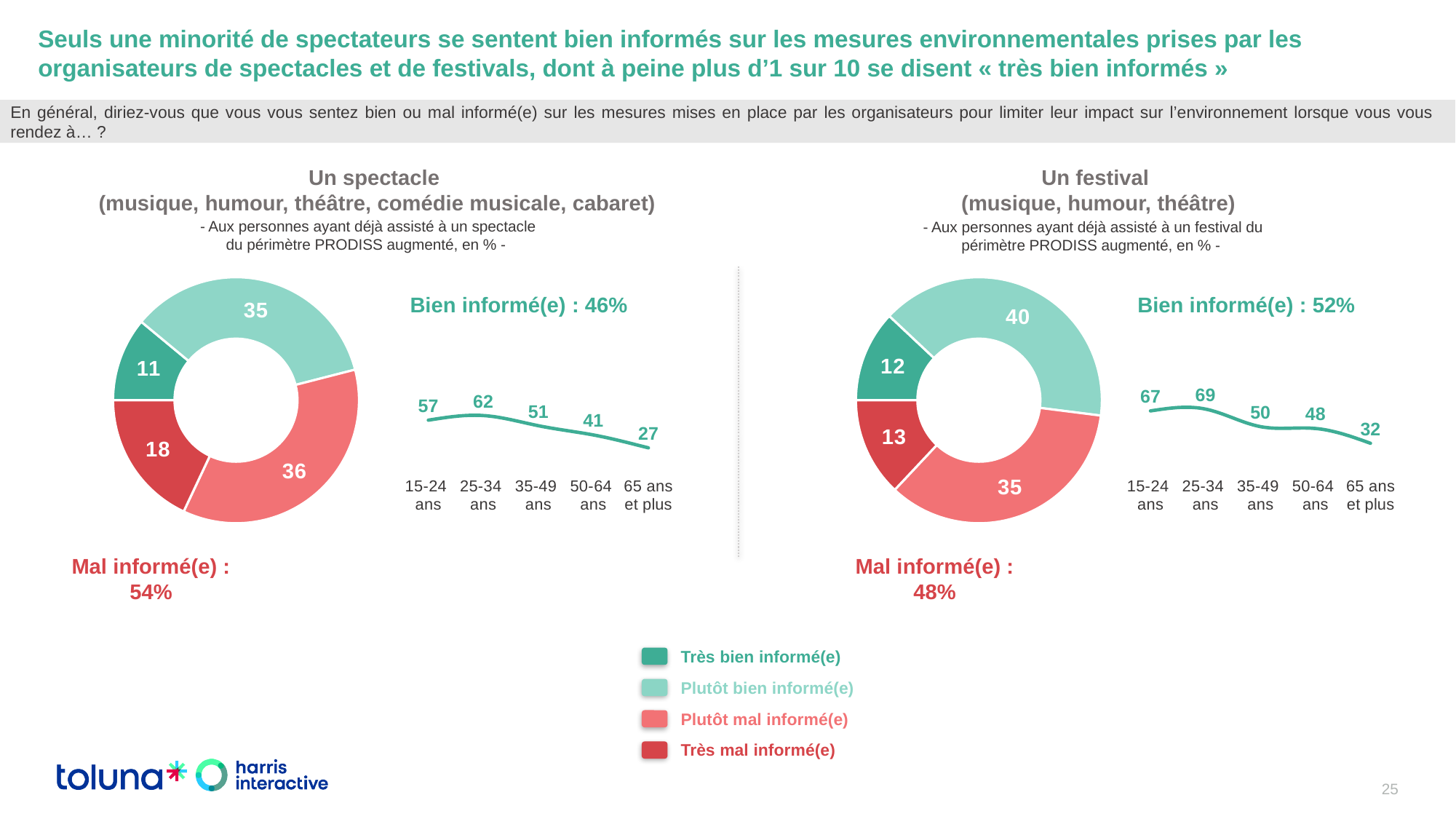
In the 'Un festival' donut chart, which is larger: 'Plutôt bien informé(e)' or 'Plutôt mal informé(e)'? Plutôt bien informé(e) How many categories does the legend list for the donut charts? 4 In the 'Un spectacle' donut chart, what is the difference between 'Plutôt mal informé(e)' and 'Très mal informé(e)'? 18 In the line chart by age group for 'Un spectacle', what is the value for '25-34 ans'? 62 In the line chart by age group for 'Un spectacle', do the values generally rise or fall from the youngest to the oldest age group? fall How many age groups are shown in the line chart for 'Un festival'? 5 In the line chart by age group for 'Un festival', what is the value for '65 ans et plus'? 32 In the 'Un spectacle' donut chart, what is the value for 'Plutôt bien informé(e)'? 35 In the line chart by age group for 'Un festival', which age group has the highest value? 25-34 ans In the 'Un spectacle' donut chart, which category has the largest value? Plutôt mal informé(e) In the 'Un festival' donut chart, what is the value for 'Très mal informé(e)'? 13 In the 'Un festival' donut chart, which category has the smallest value? Très bien informé(e)